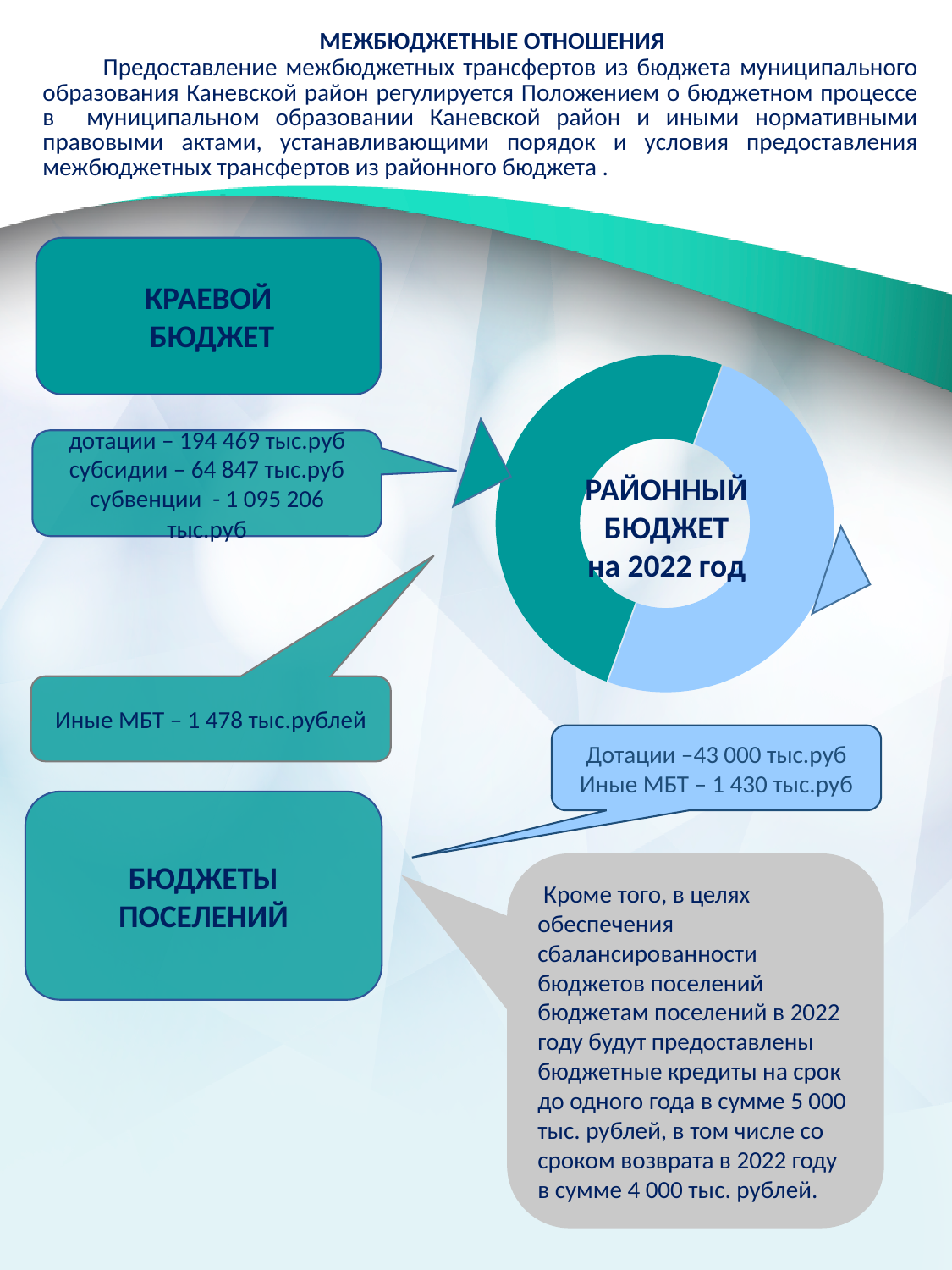
According to the callout from the краевой бюджет, what is the amount of субвенции? 1 095 206 тыс.руб According to the callout from the краевой бюджет, what is the amount of субсидии? 64 847 тыс.руб What amount of Дотации is shown in the callout pointing to бюджеты поселений? 43 000 тыс.руб According to the callout from the краевой бюджет, what is the amount of дотации? 194 469 тыс.руб What kind of chart is shown on the slide? donut chart How many segments does the donut chart have? 2 What amount of Иные МБТ is shown in the callout from the краевой бюджет? 1 478 тыс.рублей What text is written in the centre of the donut chart? РАЙОННЫЙ БЮДЖЕТ на 2022 год What two colours are used for the segments of the donut chart? teal and light blue What amount of Иные МБТ is shown in the callout pointing to бюджеты поселений? 1 430 тыс.руб